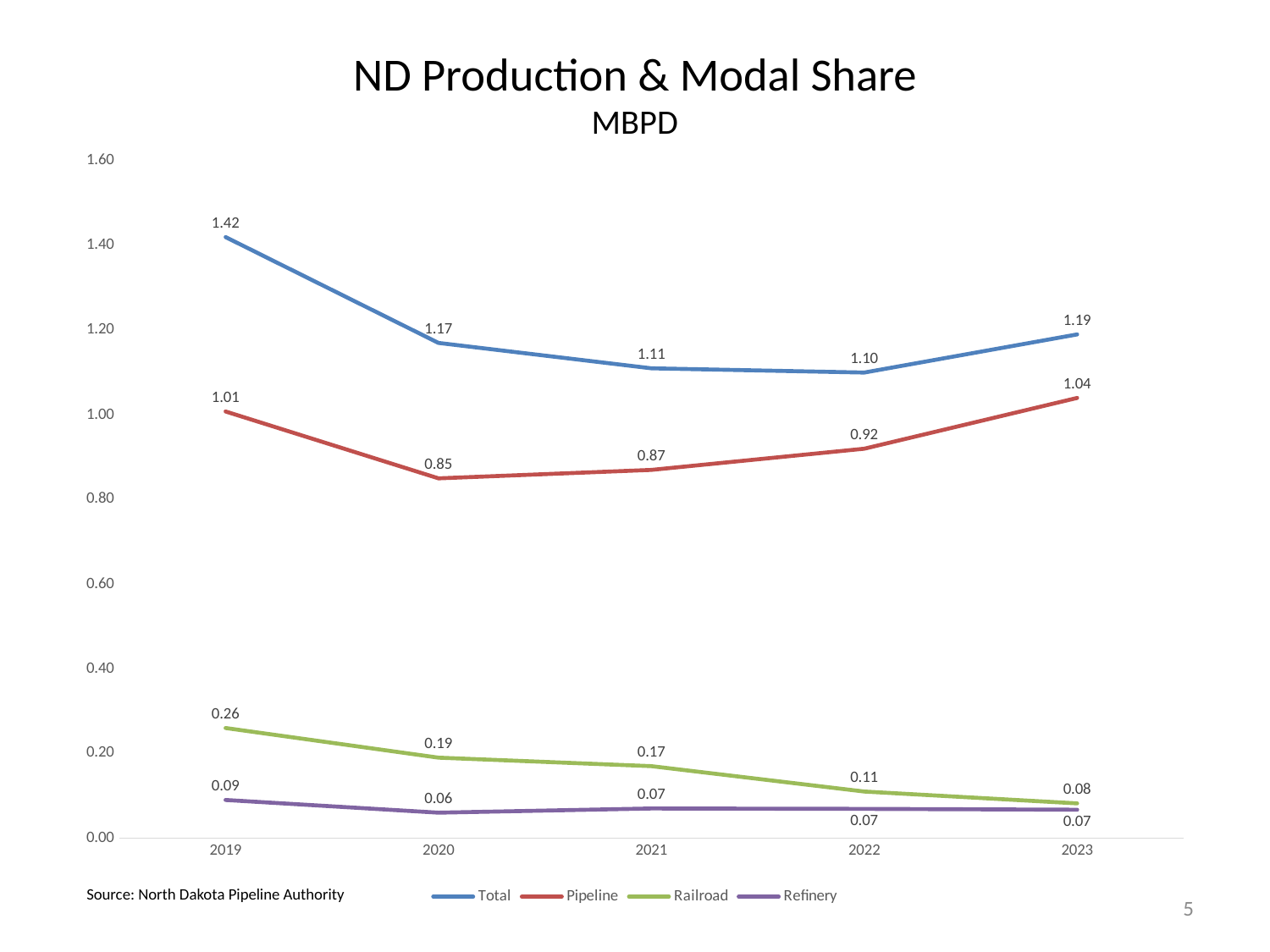
In which year is the Railroad series highest? 2019 What is the Refinery value for 2020? 0.06 What is the Total value for 2019? 1.42 How many years are shown on the x axis? 5 What is the Railroad value for 2021? 0.17 In which year is the Total series lowest? 2022 What is the Pipeline value for 2023? 1.04 Does the Railroad series rise or fall from 2019 to 2023? fall What kind of chart is shown on the slide? line chart What is the difference between the Total value in 2019 and the Total value in 2023? 0.23 How many series does the legend list? 4 Which is larger, the Pipeline value in 2020 or the Pipeline value in 2022? 2022